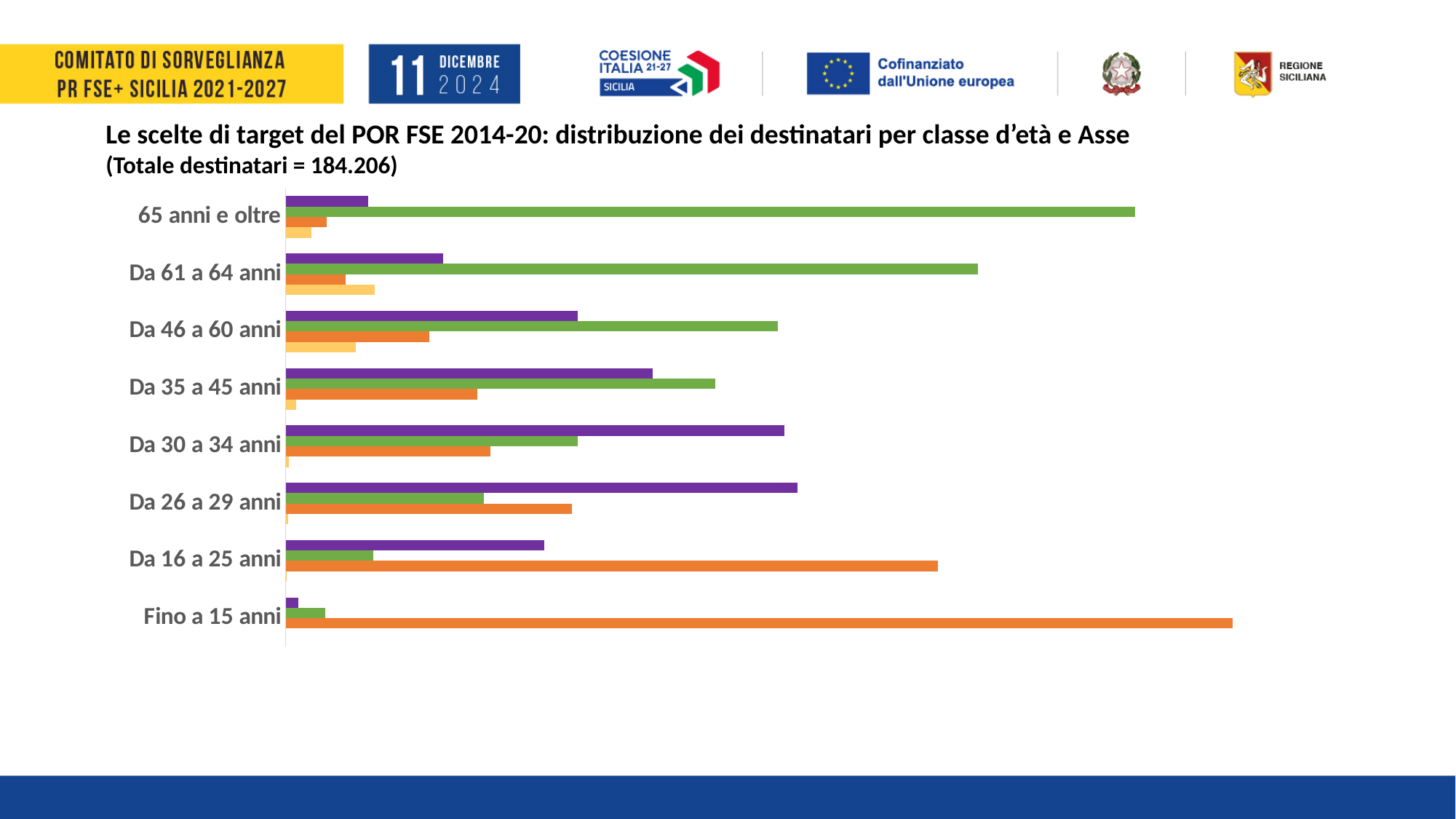
For 'Da 16 a 25 anni', which bar is longer, the orange one or the purple one? orange Moving from 'Fino a 15 anni' up to '65 anni e oltre', do the green bars get longer or shorter? longer What is the title of the chart? Le scelte di target del POR FSE 2014-20: distribuzione dei destinatari per classe d'età e Asse For 'Fino a 15 anni', which bar is longer, the orange one or the green one? orange For '65 anni e oltre', which bar is longer, the green one or the purple one? green Which age class has the longest green bar? 65 anni e oltre Which age class has the shortest purple bar? Fino a 15 anni What total number of destinatari is stated under the chart title? 184.206 Moving from 'Fino a 15 anni' up to '65 anni e oltre', do the orange bars get longer or shorter? shorter Which age class has the longest orange bar? Fino a 15 anni What kind of chart is shown on the slide? bar chart How many age classes are shown on the chart? 8